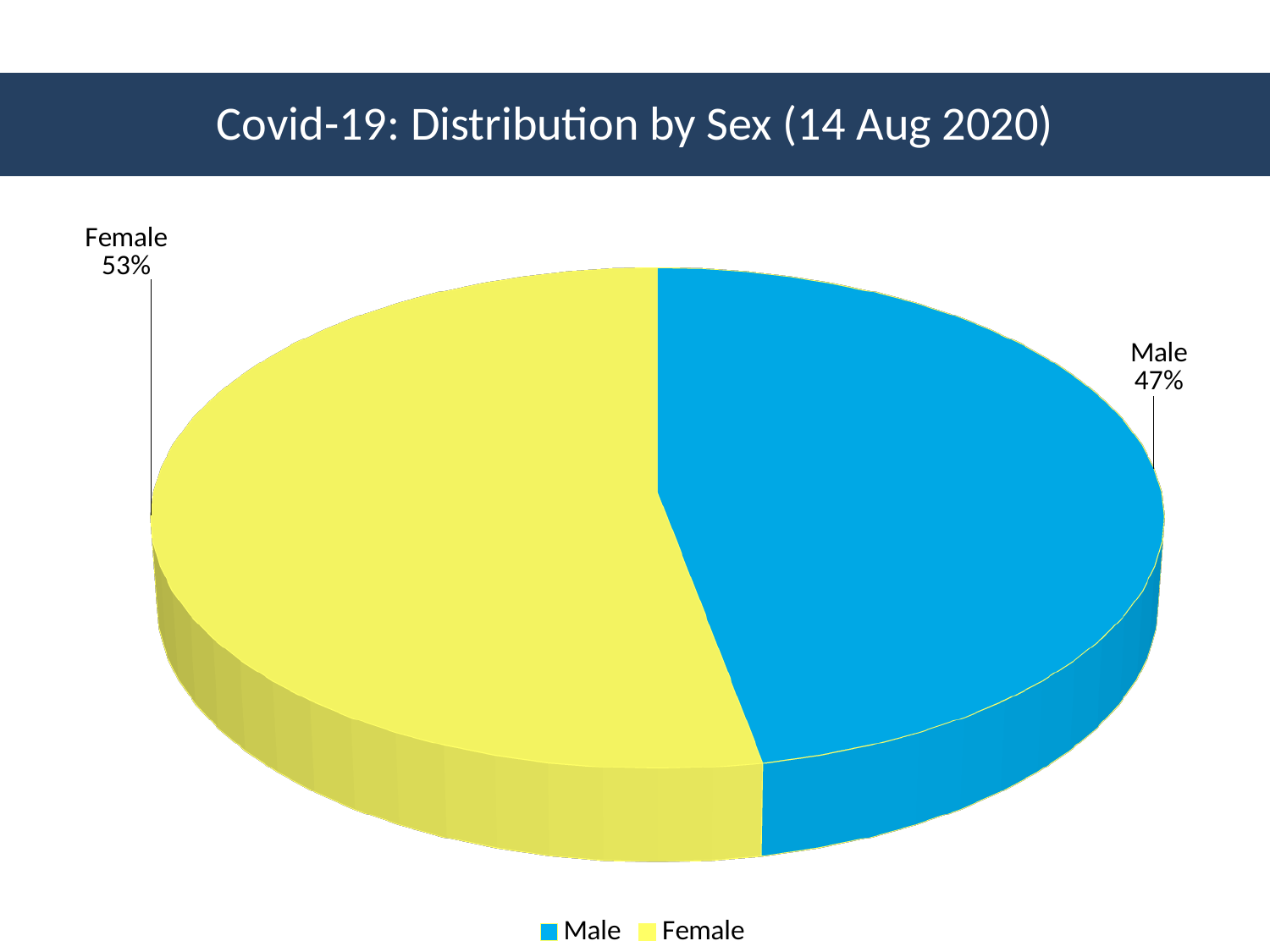
What is the title of the chart? Covid-19: Distribution by Sex (14 Aug 2020) How many slices does the pie chart have? 2 Which category has the smallest slice of the pie? Male How many entries does the legend list? 2 Is the Male share greater or less than 50%? less What share of the pie does Female account for? 53% What share of the pie does Male account for? 47% What colour is the Male slice? Blue What is the difference in percentage points between the Female and Male slices? 6 Which slice is larger, Male or Female? Female What kind of chart is shown on the slide? Pie chart Which category has the largest slice of the pie? Female